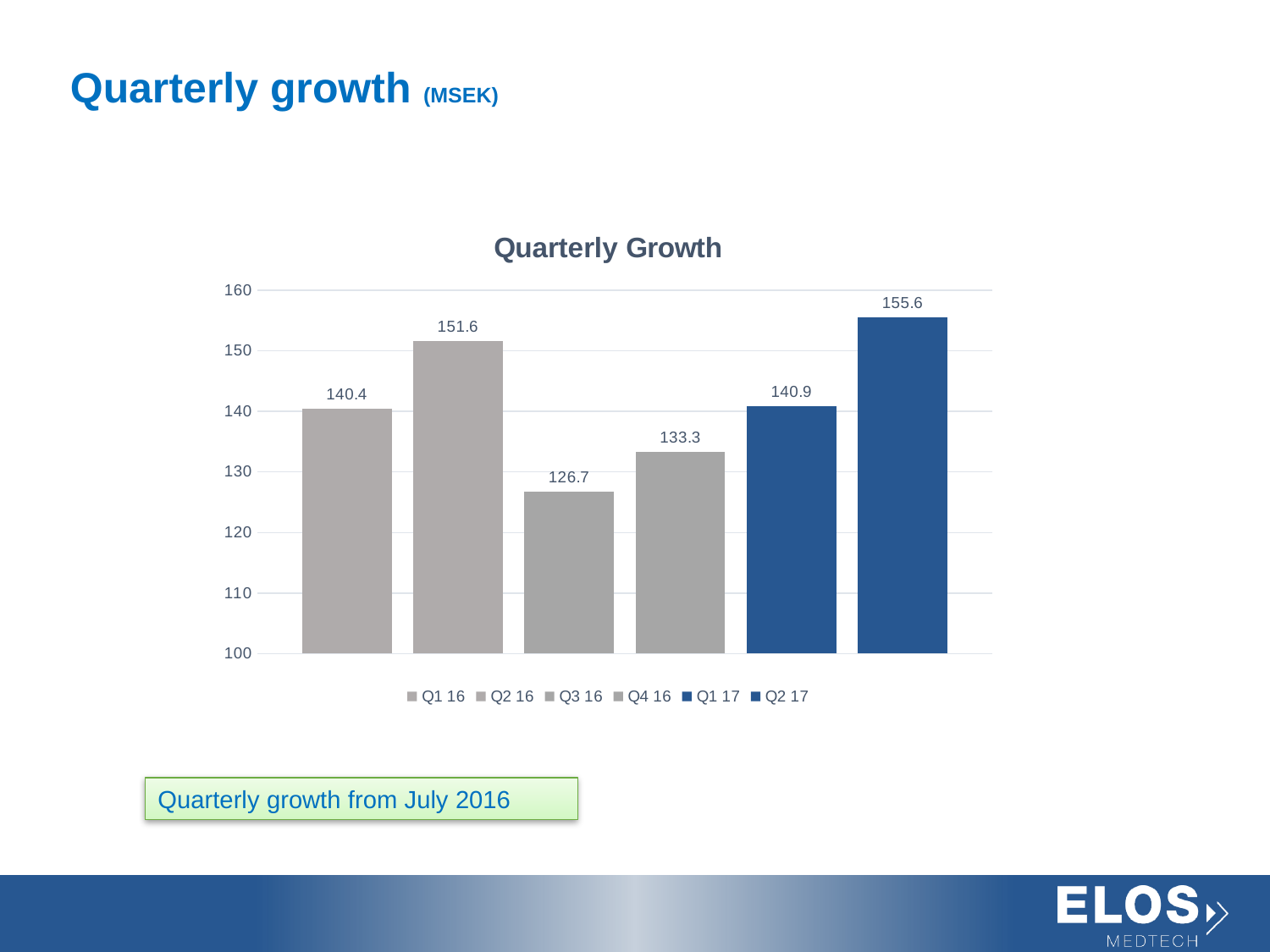
Which is larger, Q4 16 or Q1 17? Q1 17 How many quarters are shown in the chart? 6 What is the difference between Q2 16 and Q3 16? 24.9 Which quarter has the highest value? Q2 17 What kind of chart is shown on the slide? Bar chart Is the value for Q2 16 greater or less than 150? greater What is the value for Q3 16? 126.7 What is the difference between Q2 17 and Q1 17? 14.7 What is the value for Q1 16? 140.4 What is the value for Q2 17? 155.6 What is the title of the chart? Quarterly Growth Which quarter has the lowest value? Q3 16